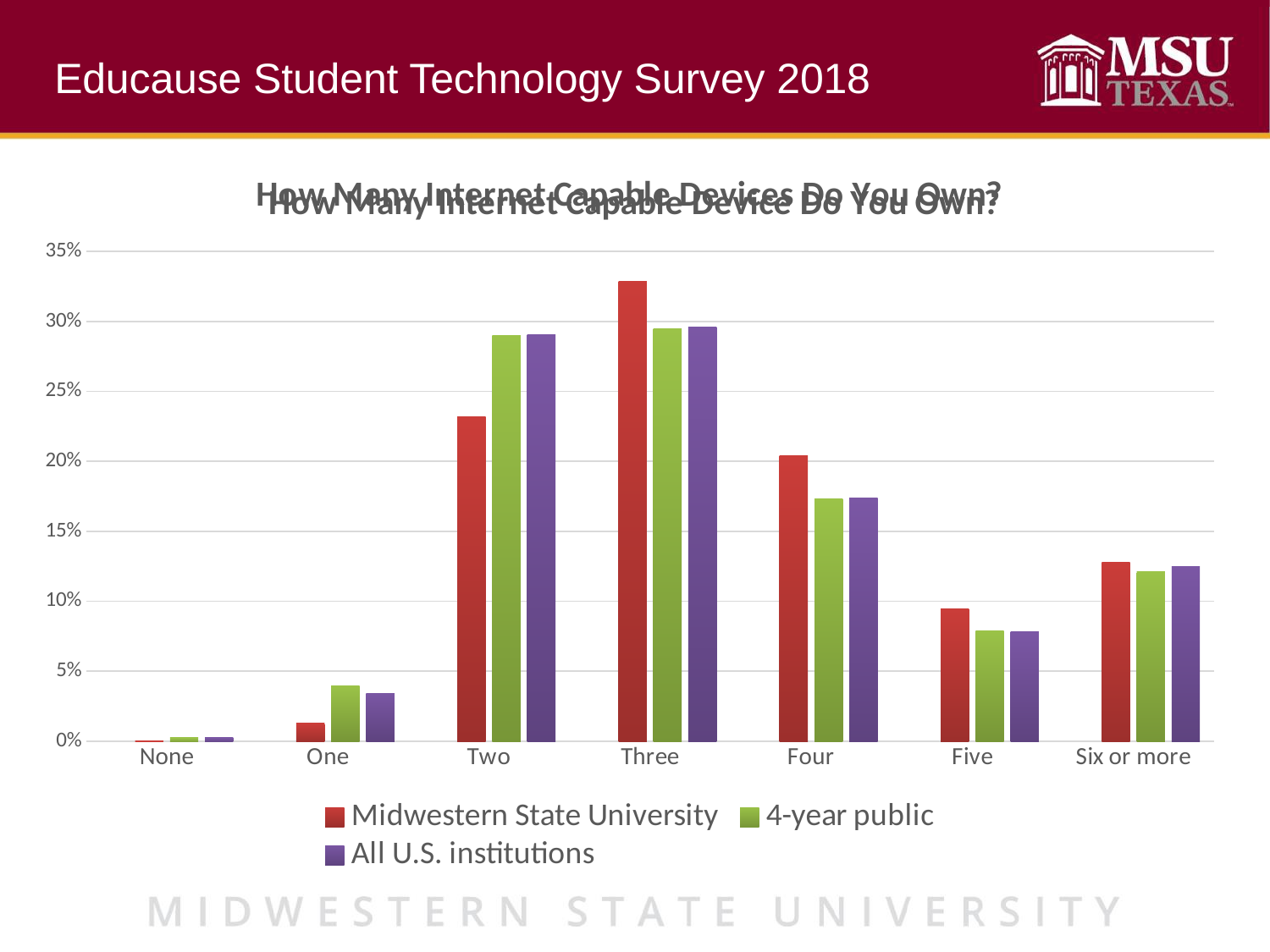
Is the Midwestern State University value for Three greater or less than 30%? greater What are the three series listed in the legend? Midwestern State University, 4-year public, All U.S. institutions Is the Midwestern State University value for Five greater or less than 10%? less What kind of chart is shown on the slide? bar chart Which category has the lowest value for Midwestern State University? None How many series does the legend list? 3 For the Four category, which is larger: Midwestern State University or 4-year public? Midwestern State University For the Two category, which is larger: Midwestern State University or All U.S. institutions? All U.S. institutions How many categories are shown along the x axis? 7 Which category has the highest value for Midwestern State University? Three Is the Midwestern State University value for Two greater or less than 25%? less